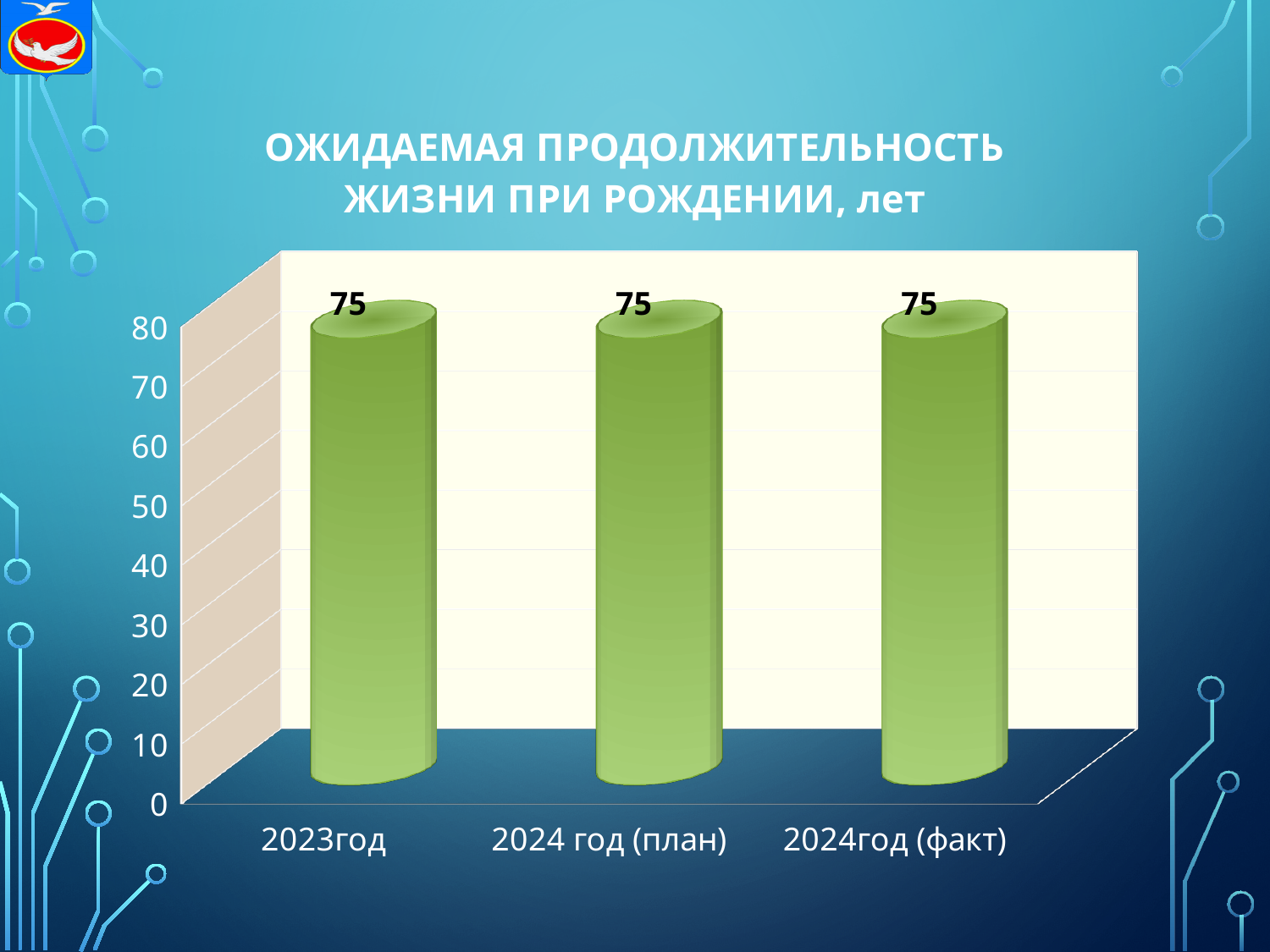
What kind of chart is shown on the slide? Bar chart Is the value for 2023год greater or less than 70? greater What is the value for 2024 год (план)? 75 How many categories are shown on the x axis? 3 Do the values rise, fall or stay the same from 2023год to 2024год (факт)? Stay the same What is the highest value shown on the vertical axis? 80 What is the difference between the values for 2023год and 2024год (факт)? 0 What is the value for 2024год (факт)? 75 What is the difference between the values for 2024 год (план) and 2024год (факт)? 0 What is the title of the chart? ОЖИДАЕМАЯ ПРОДОЛЖИТЕЛЬНОСТЬ ЖИЗНИ ПРИ РОЖДЕНИИ, лет What is the value for 2023год? 75 Is the value for 2024год (факт) greater or less than 80? less